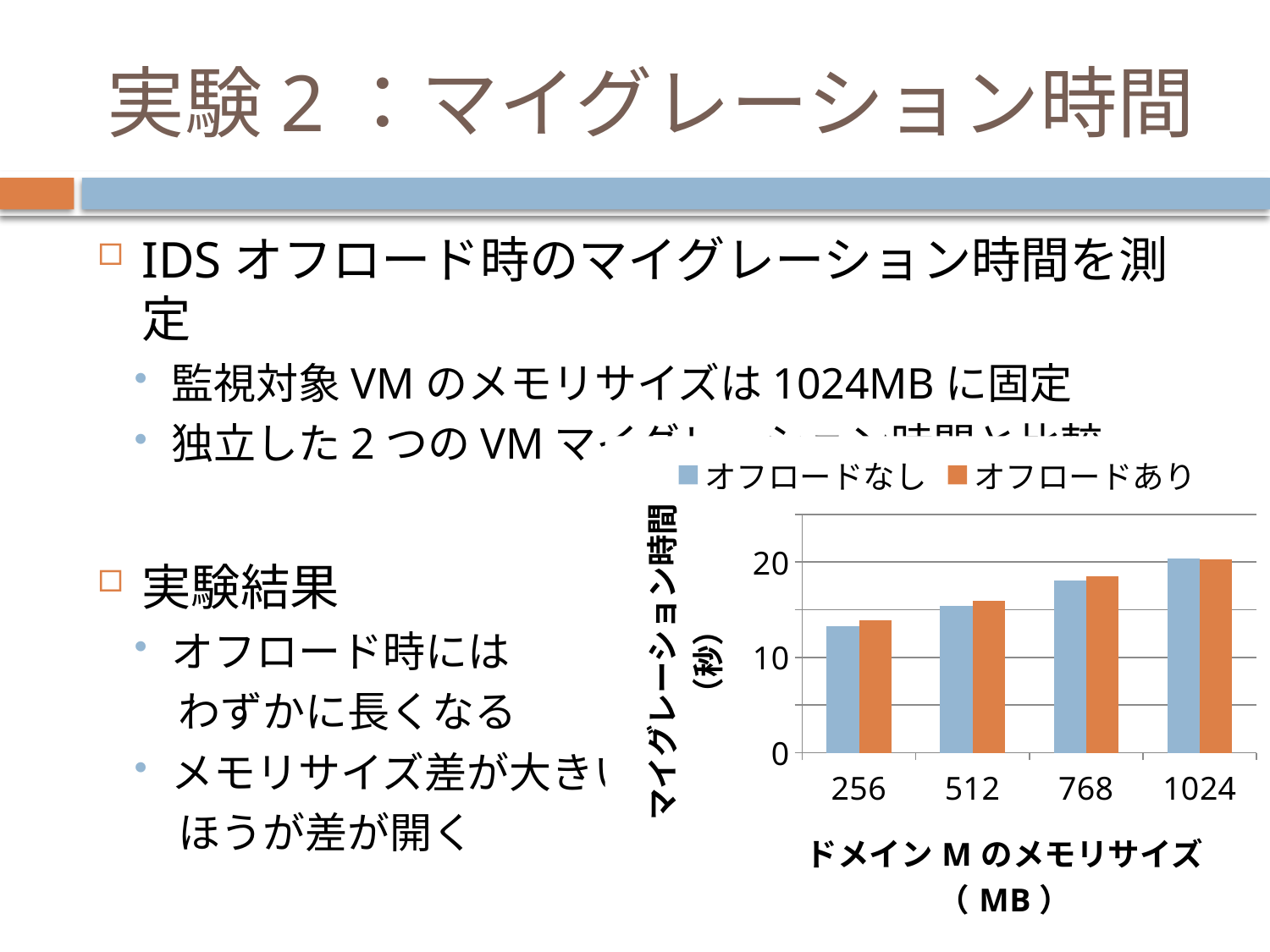
What is the title of the x axis of the chart? ドメインMのメモリサイズ（MB） Which memory size has the lowest migration time for オフロードあり? 256 How many series does the chart legend list? 2 Which is larger for オフロードなし: the migration time at 256 MB or at 1024 MB? 1024 MB Do the migration times for オフロードなし rise or fall as the memory size increases along the x axis? rise How many memory-size categories are shown on the x axis of the chart? 4 What kind of chart is shown on the slide? bar chart Is the migration time for オフロードなし at 256 MB greater or less than 20? less Which memory size has the highest migration time for オフロードなし? 1024 Is the migration time for オフロードあり at 256 MB greater or less than 10? greater What are the two series named in the chart legend? オフロードなし and オフロードあり Is the migration time for オフロードあり at 768 MB greater or less than 20? less